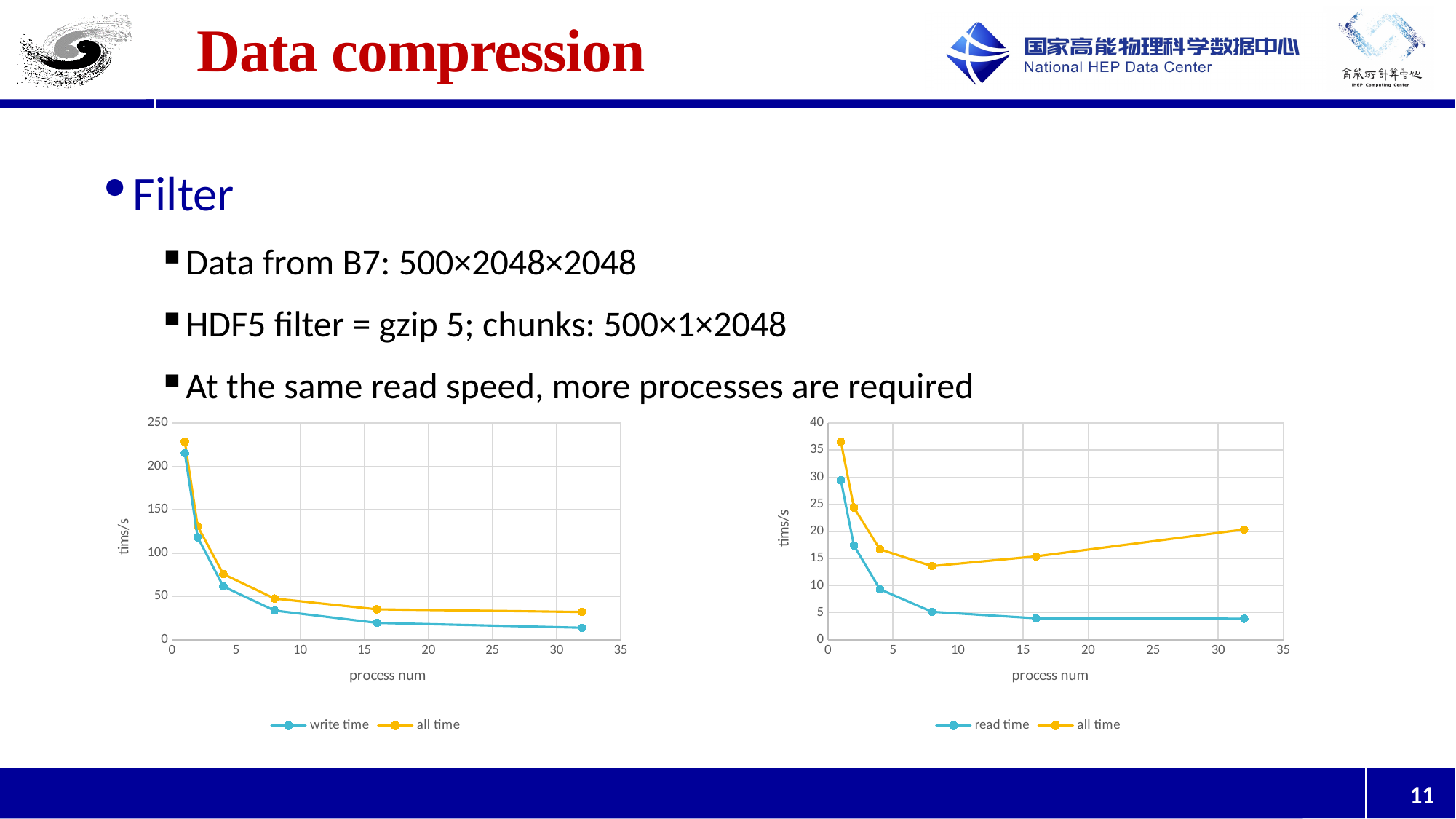
In the right chart, which series has the larger value at process num 32, read time or all time? all time What are the two series named in the legend of the left chart? write time and all time In the left chart, does the write time rise or fall as process num increases? fall How many series does the legend of the right chart list? 2 In the right chart, at which process num is the read time highest? 1 In the left chart, is the all time value at process num 32 greater or less than 50? less How many data points does the write time series have in the left chart? 6 In the right chart, is the read time value at process num 32 greater or less than 5? less In the right chart, is the all time value at process num 32 greater or less than 15? greater What kind of chart is the left chart on the slide? line chart What is the x-axis title of the right chart? process num